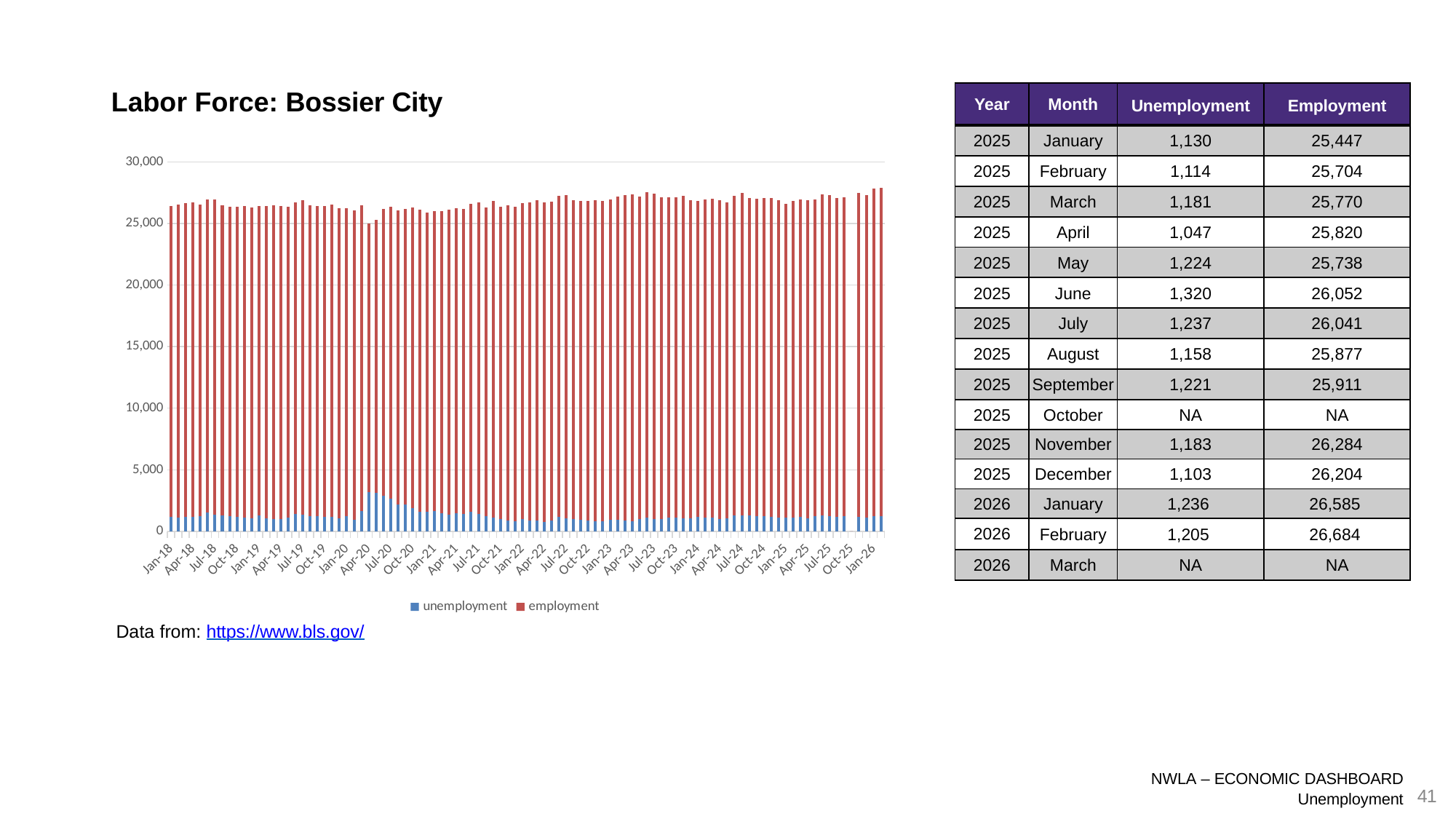
Does the unemployment series generally rise or fall from Apr-20 to Jan-21? fall Is the unemployment value for Apr-20 greater or less than 5,000? less According to the table on the slide, what was employment in Bossier City in February 2026? 26,684 Which series has the larger value in Jan-18, unemployment or employment? employment What kind of chart is shown on the slide? bar chart Which is larger, the unemployment value for Apr-20 or the unemployment value for Jan-18? Apr-20 Around which period does the unemployment series reach its highest value? Apr-20 What is the title of the chart? Labor Force: Bossier City Is the employment value for Jan-18 greater or less than 25,000? greater Is the employment value for Jan-26 greater or less than 30,000? less What are the two series named in the chart legend? unemployment and employment How many series does the chart legend list? 2